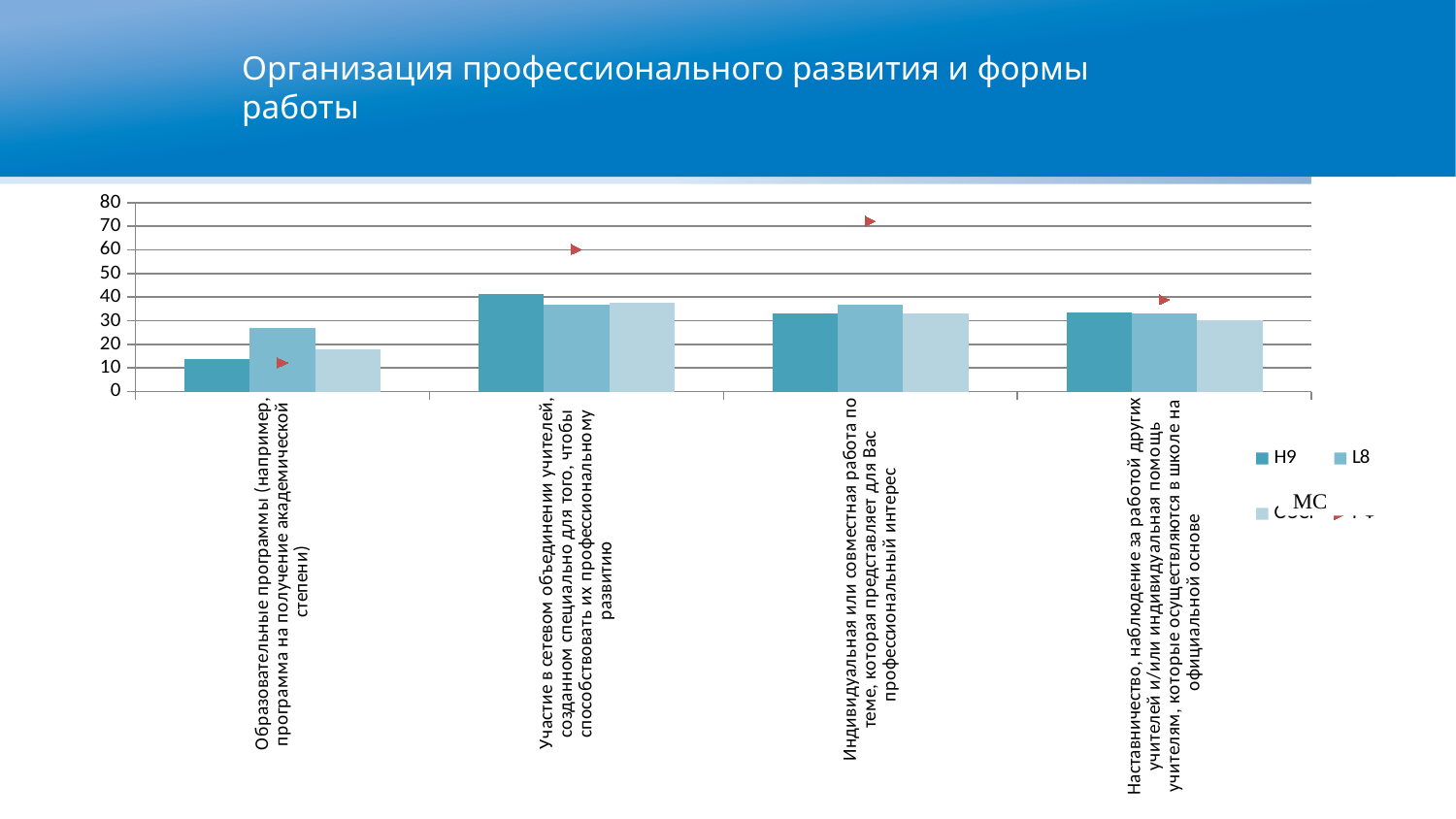
How many categories are shown on the x axis of the chart? 4 How many entries does the chart legend list? 4 What kind of chart is shown on the slide? bar chart Is the L8 value for 'Образовательные программы' greater or less than 20? greater For 'Образовательные программы', which is larger, the H9 bar or the L8 bar? L8 Which category has the lowest H9 bar? Образовательные программы (например, программа на получение академической степени) Is the H9 value for 'Участие в сетевом объединении учителей' greater or less than 30? greater For 'Участие в сетевом объединении учителей', which is larger, the H9 bar or the L8 bar? H9 Which category has the highest H9 bar? Участие в сетевом объединении учителей Is the H9 value for 'Образовательные программы' greater or less than 20? less What is the title of the slide? Организация профессионального развития и формы работы